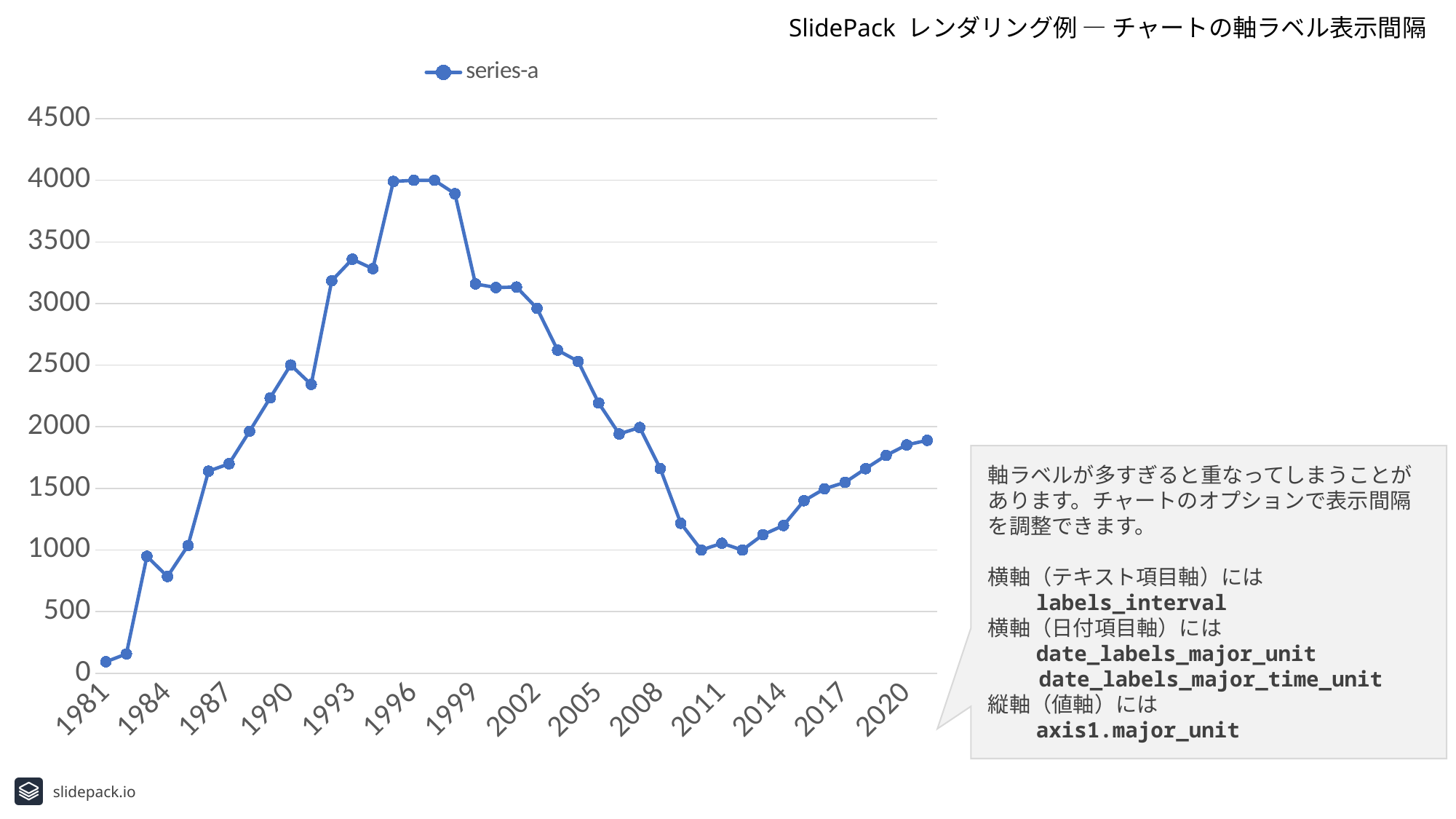
Which is larger, the value for series-a in 1999 or in 2011? 1999 How many series does the legend list? 1 Does the value of series-a rise or fall between 1999 and 2011? fall Which labelled year on the x axis has the lowest value for series-a? 1981 What is the highest value shown on the vertical axis? 4500 How many year labels are shown on the x axis? 14 What is the name of the series shown in the legend? series-a What kind of chart is shown on the slide? line chart Is the value for series-a in 1999 greater or less than 3000? greater Is the value for series-a in 2014 greater or less than 1500? less Is the value for series-a in 1981 greater or less than 500? less